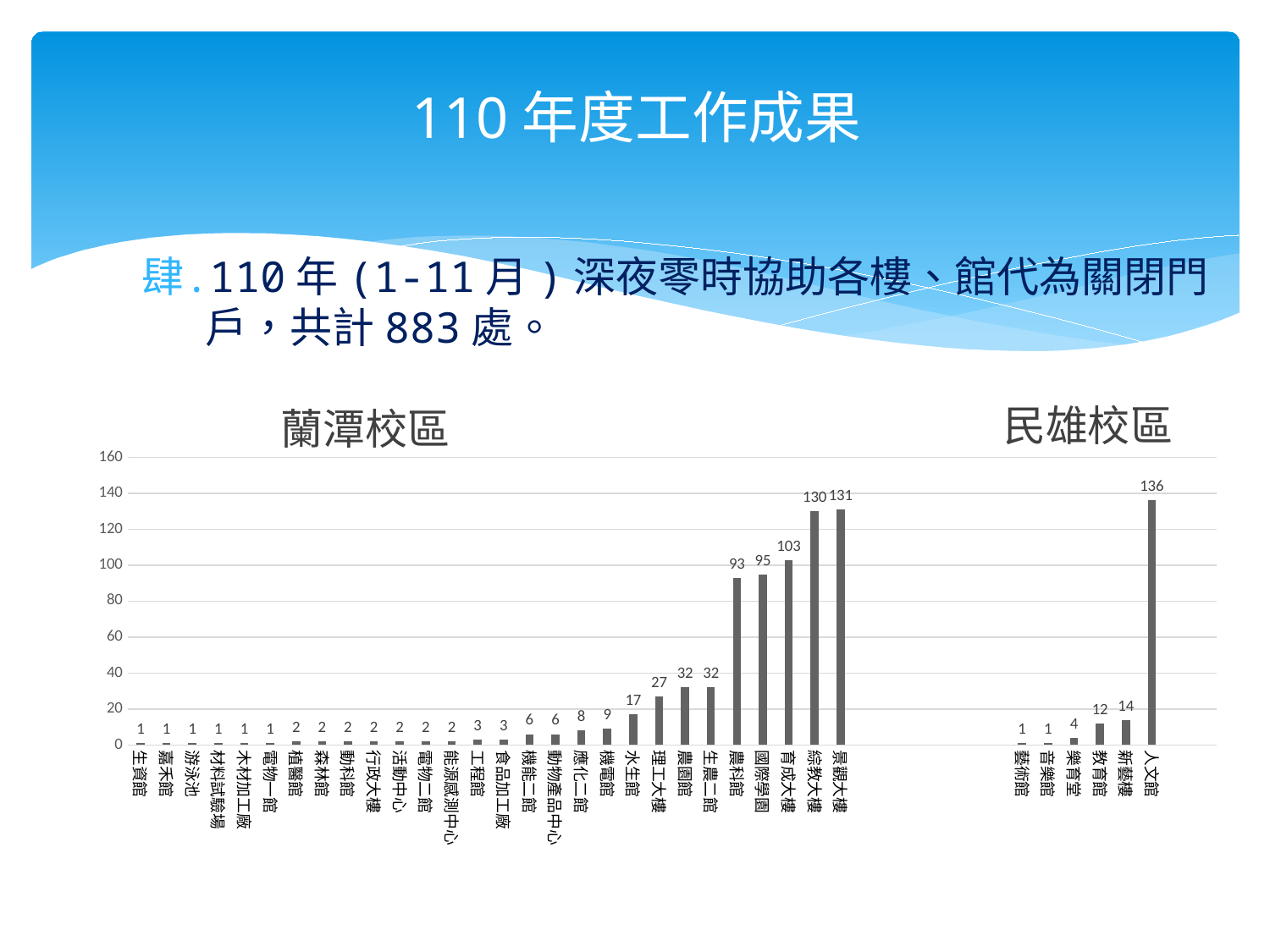
What is the value for 人文館 in the 民雄校區 section of the chart? 136 What is the total of the values for 教育館 and 新藝樓? 26 What is the value for 景觀大樓 in the 蘭潭校區 section of the chart? 131 Which category has the highest value in the 蘭潭校區 section? 景觀大樓 Which category has the highest value across the whole chart? 人文館 What is the value for 新藝樓 on the chart? 14 Which is larger, the value for 國際學園 or the value for 農科館? 國際學園 Is the value for 理工大樓 greater or less than 20? greater What kind of chart is shown on the slide? bar chart What is the difference between the values for 綜教大樓 and 農科館? 37 What is the value for 育成大樓 on the chart? 103 How many categories are shown in the 民雄校區 section of the chart? 6